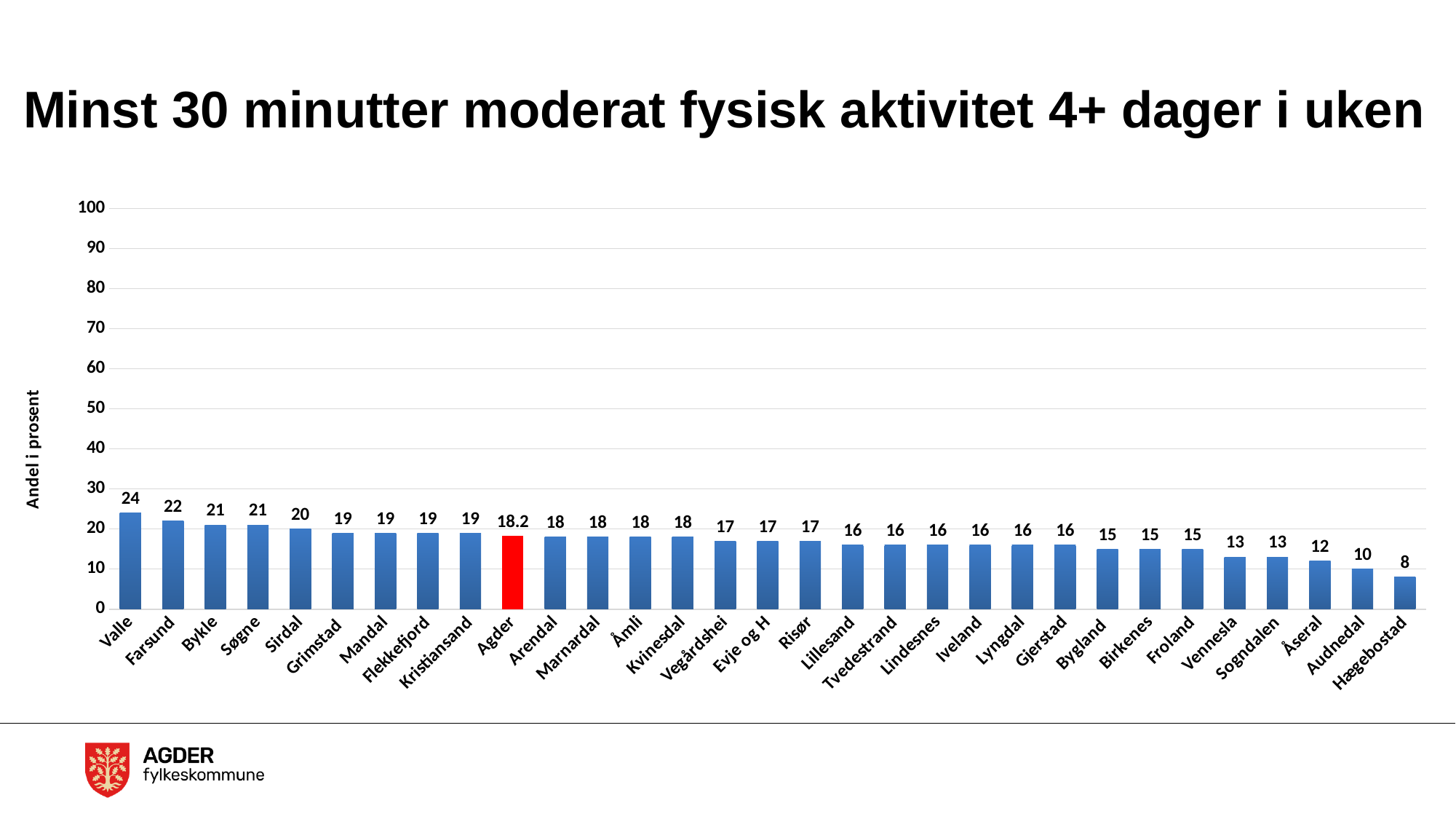
Which bar is coloured red? Agder Which is larger, the value for Farsund or the value for Audnedal? Farsund What is the value for Vennesla? 13 Which category has the highest value? Valle What is the value for Agder? 18.2 Is the value for Sirdal greater or less than 30? less How many categories are shown on the x axis? 31 What is the difference between the values for Valle and Hægebostad? 16 What is the value for Hægebostad? 8 What kind of chart is this? bar chart What is the value for Valle? 24 Which category has the lowest value? Hægebostad